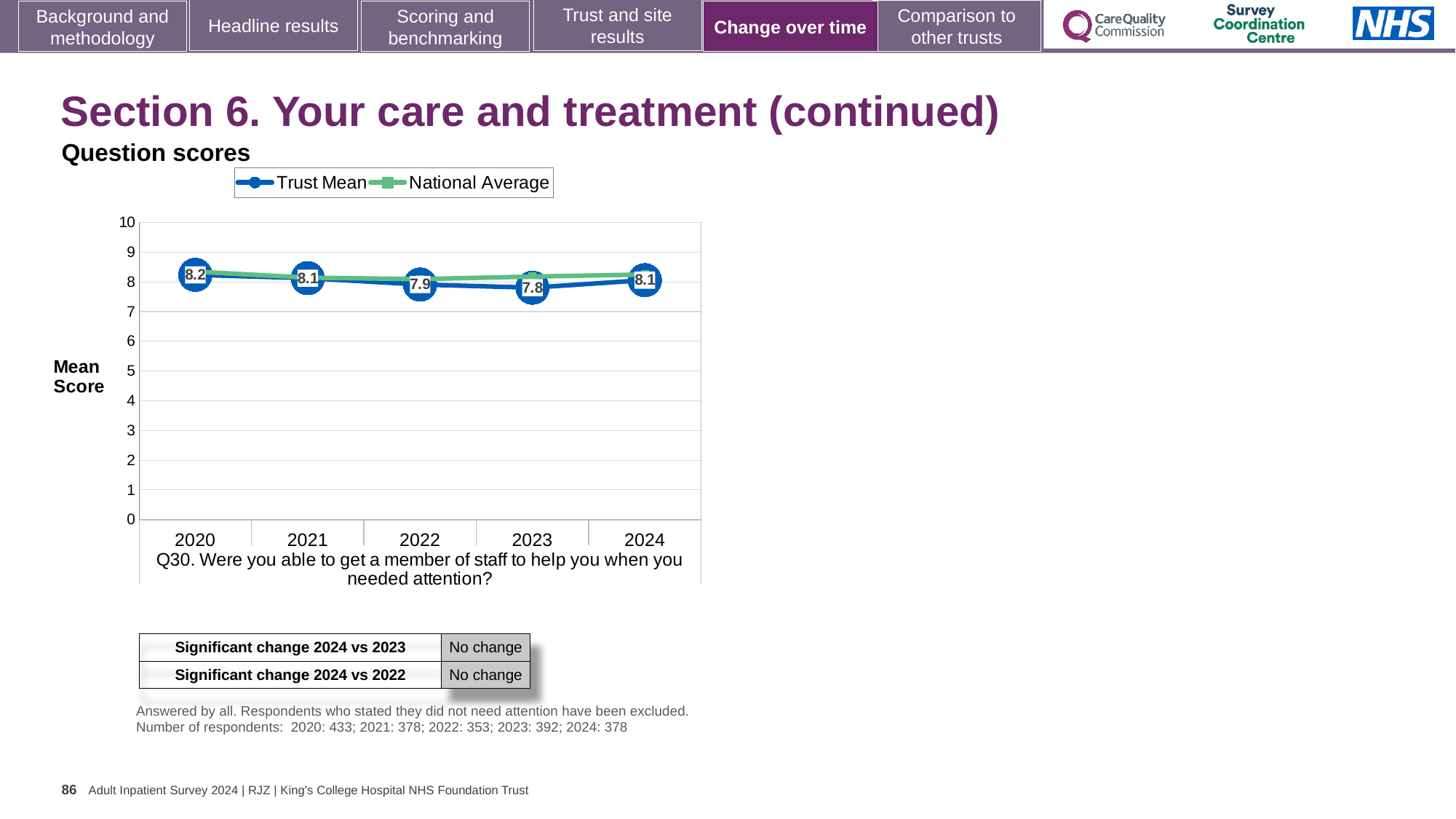
Does the Trust Mean rise or fall from 2020 to 2023? Fall What is the difference between the Trust Mean in 2020 and in 2023? 0.4 How many series does the legend list? 2 What is the Trust Mean score for 2023? 7.8 What is the Trust Mean score for 2024? 8.1 Is the National Average value for 2023 greater or less than 7? greater What is the Trust Mean score for 2020? 8.2 Which is larger, the Trust Mean in 2022 or in 2024? 2024 In which year is the Trust Mean highest? 2020 What kind of chart is shown? Line chart In which year is the Trust Mean lowest? 2023 How many years are plotted on the x axis? 5